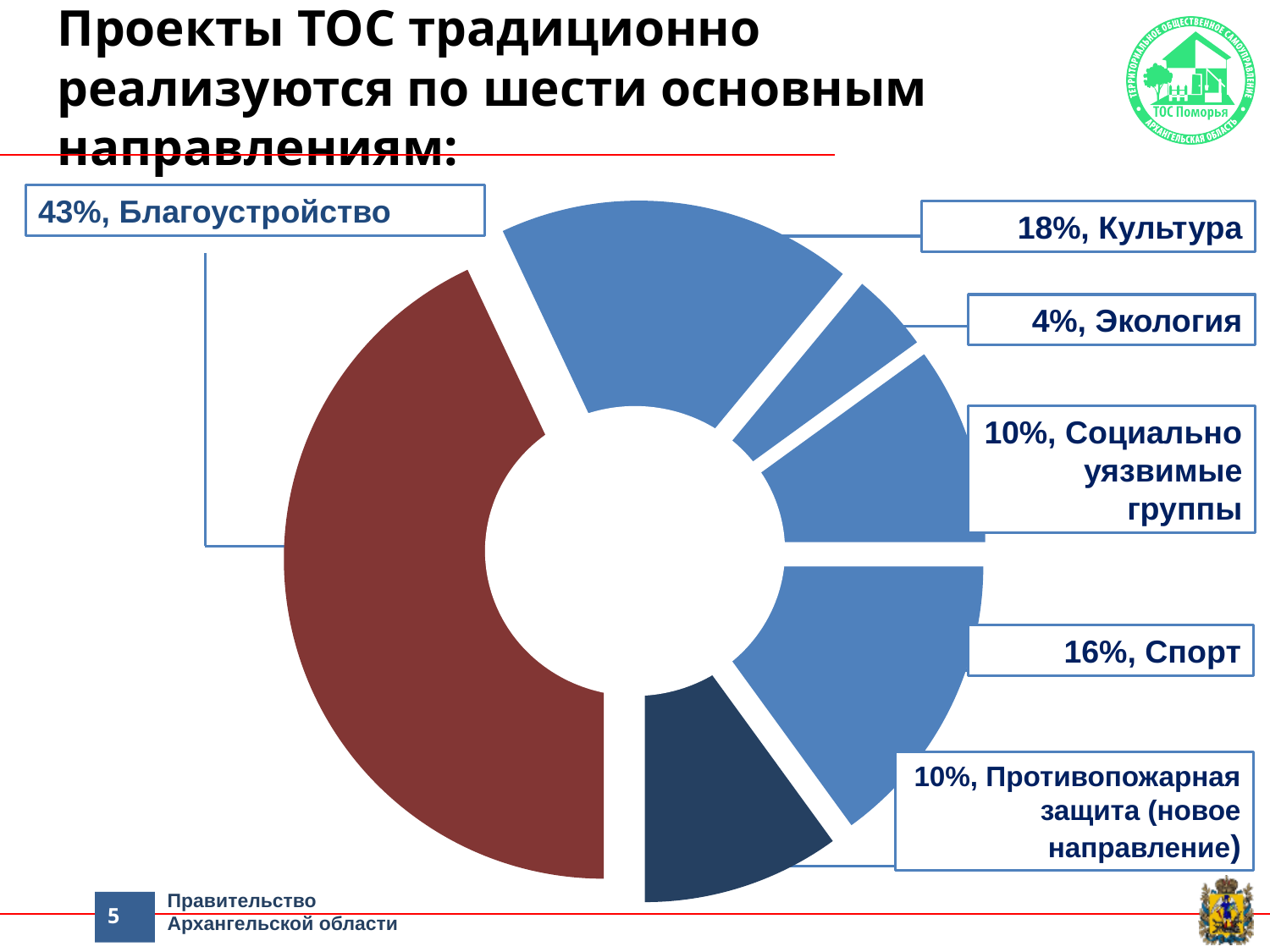
What percentage is shown for Экология? 4% Which direction has the smallest share of the chart? Экология What percentage is shown for Культура? 18% Which has a larger share, Культура or Спорт? Культура Which direction has the largest share of the chart? Благоустройство What kind of chart is shown on the slide? Doughnut (pie) chart What is the difference in percentage points between Благоустройство and Культура? 25 What share of TOS projects is for Благоустройство? 43% What percentage is shown for Противопожарная защита (новое направление)? 10% What percentage is shown for Спорт? 16% Which slice of the chart is coloured dark red? Благоустройство How many directions (slices) does the chart show? 6